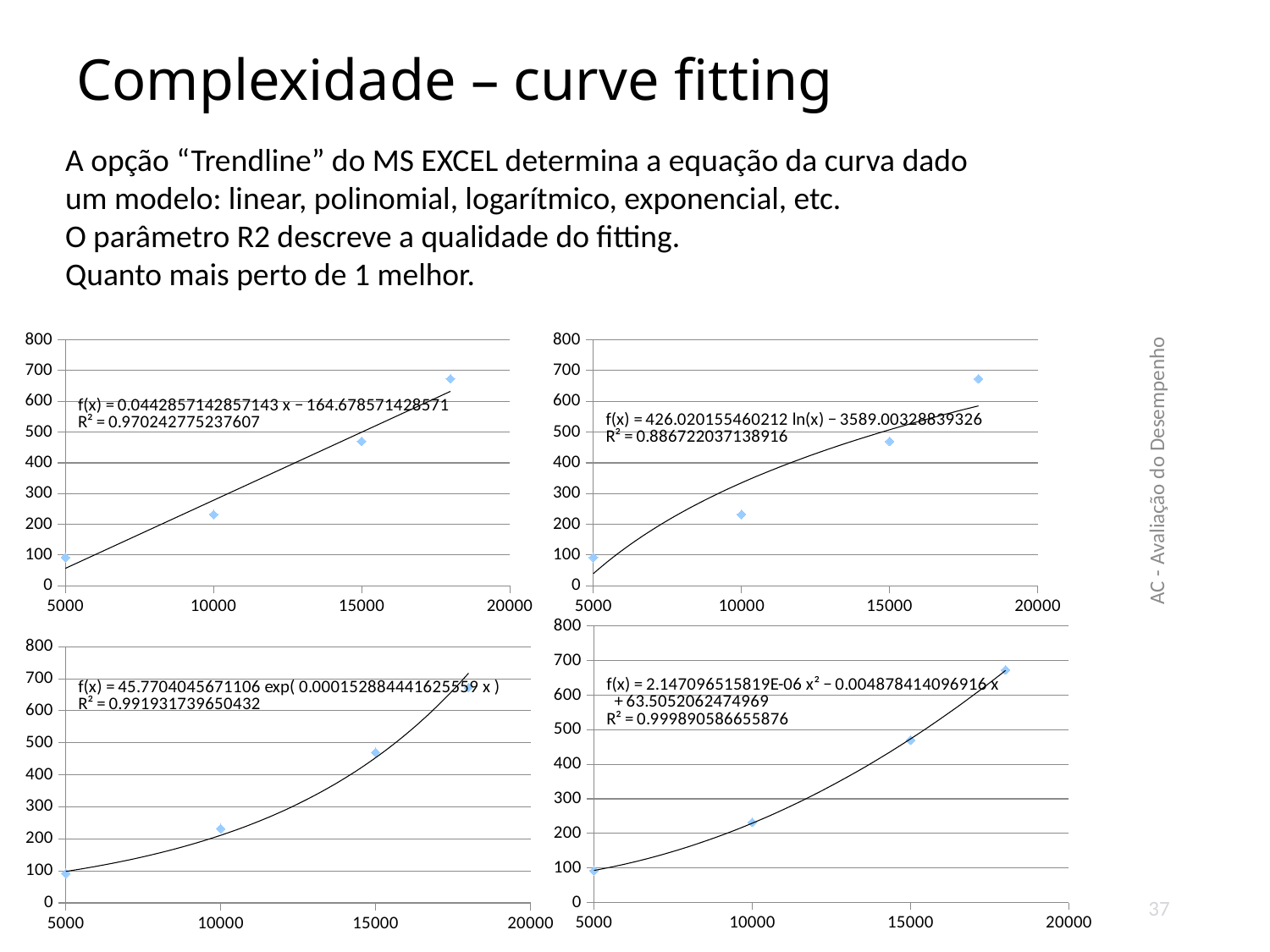
In the top-left chart, how many data points are plotted? 4 In the bottom-right chart, is the value of the highest plotted point greater or less than 600? greater In the top-left chart, is the value of the point at x = 5000 greater or less than 200? less In the top-left chart, is the highest plotted value at the leftmost or the rightmost point? rightmost In the top-right chart, which point has the larger value: the one at x = 10000 or the one at x = 15000? x = 15000 In the bottom-right chart, do the plotted values rise or fall as x increases from 5000 to 20000? rise What R² value is shown on the bottom-right chart? 0.999890586655876 In the top-right chart, is the value of the point at x = 10000 greater or less than 300? less What R² value is shown on the top-left chart? 0.970242775237607 What kind of chart is the top-left chart on the slide? scatter chart